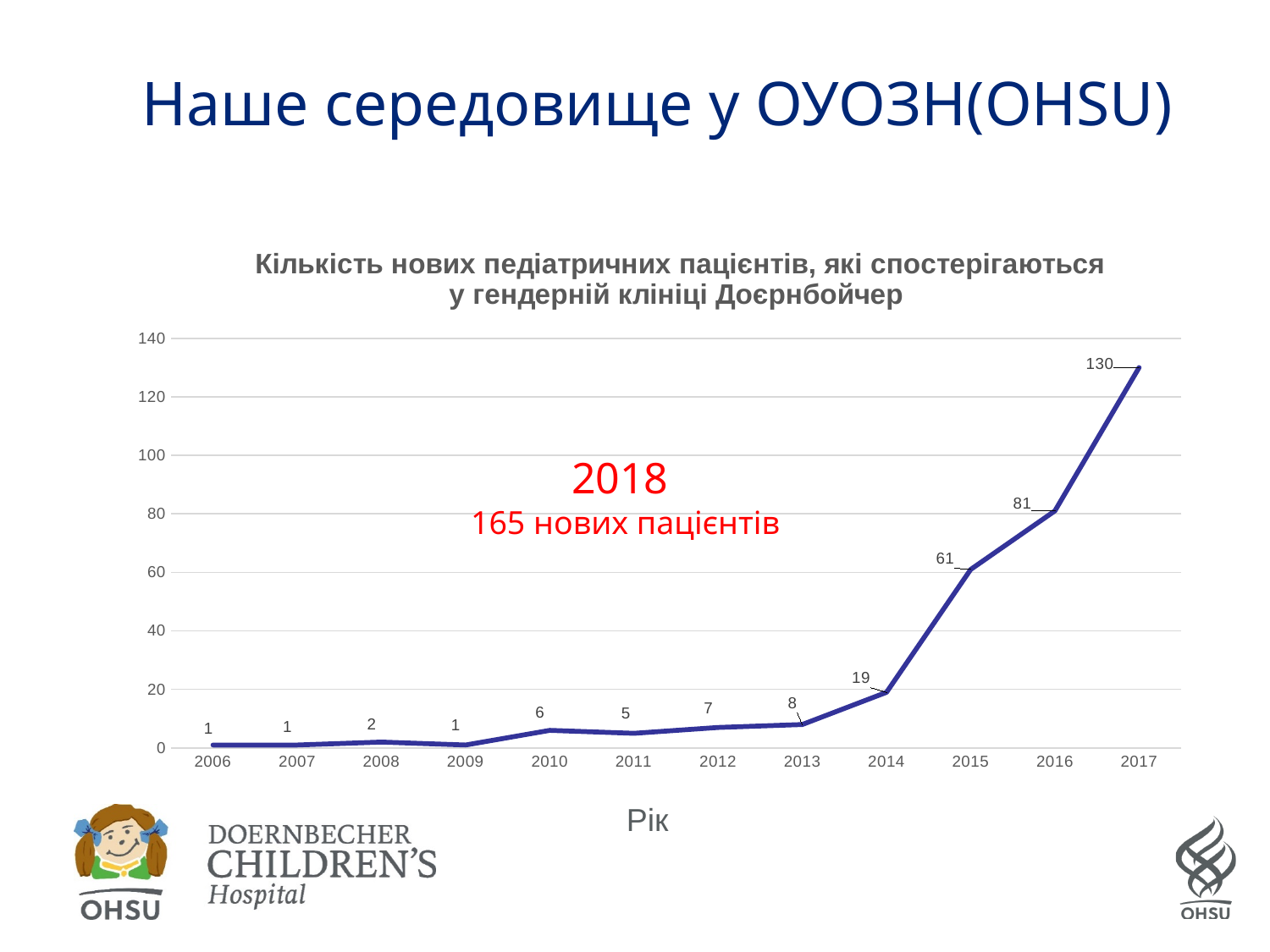
What is the number of new pediatric patients in 2014? 19 Do the values generally rise or fall from 2013 to 2017? rise What is the number of new pediatric patients in 2017? 130 Is the value for 2016 greater or less than 100? less How many years are plotted on the x axis? 12 What is the difference in new pediatric patients between 2017 and 2016? 49 What is the label of the x axis? Рік What is the difference in new pediatric patients between 2015 and 2014? 42 What is the number of new pediatric patients in 2010? 6 What kind of chart is shown on the slide? line chart Which year had more new pediatric patients, 2012 or 2011? 2012 Which year has the highest number of new pediatric patients? 2017